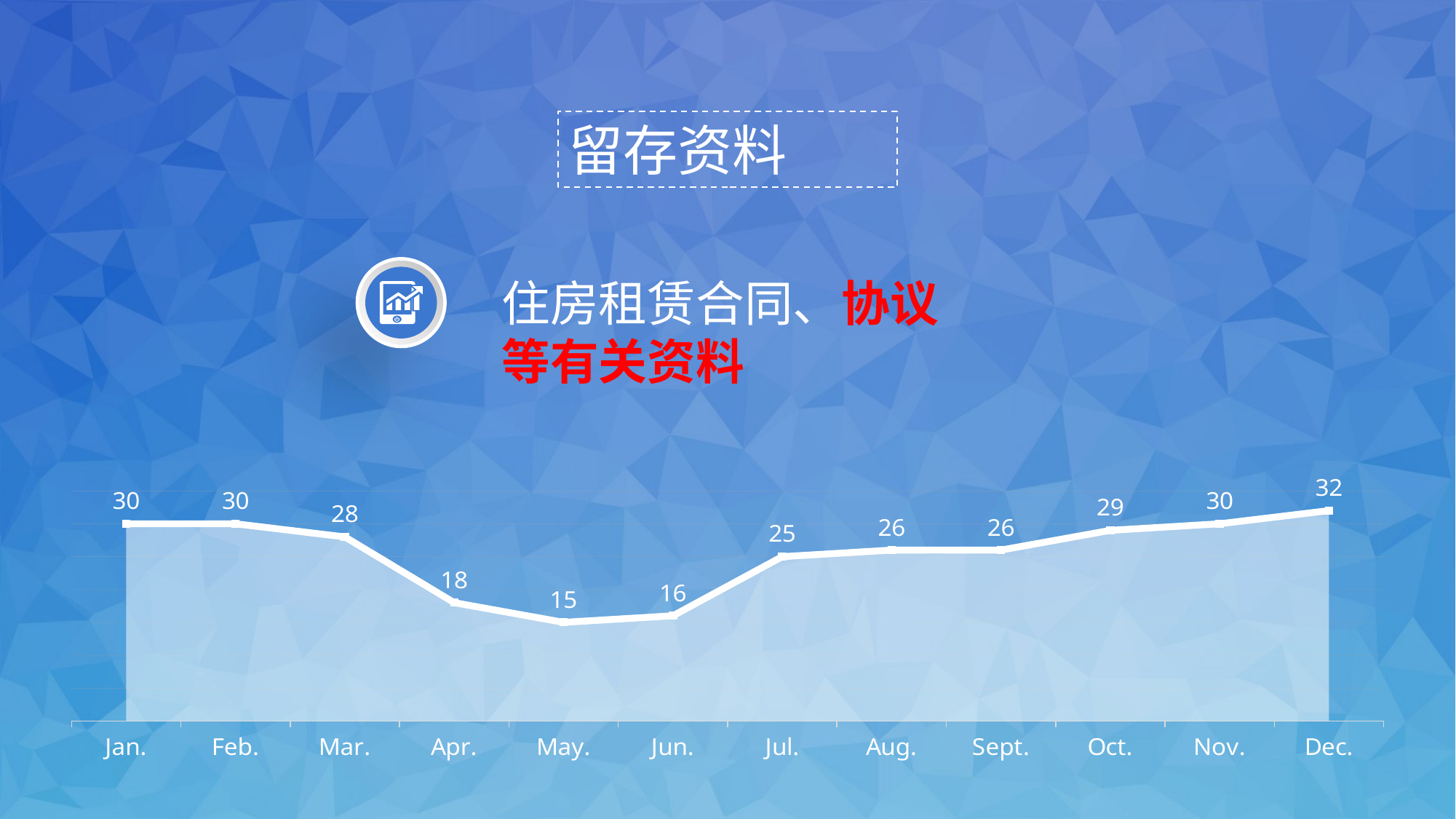
What kind of chart is shown on the slide? Area chart Do the values rise or fall from Jul. to Dec.? Rise Which month has the highest value? Dec. Which is larger, the value for Jun. or the value for Aug.? Aug. What is the value for Jul.? 25 What is the difference between the values for Mar. and Apr.? 10 How many months are plotted on the x axis? 12 What is the difference between the values for Dec. and May.? 17 Do the values rise or fall from Feb. to May.? Fall What is the value for Oct.? 29 What is the value for Mar.? 28 Which month has the lowest value? May.